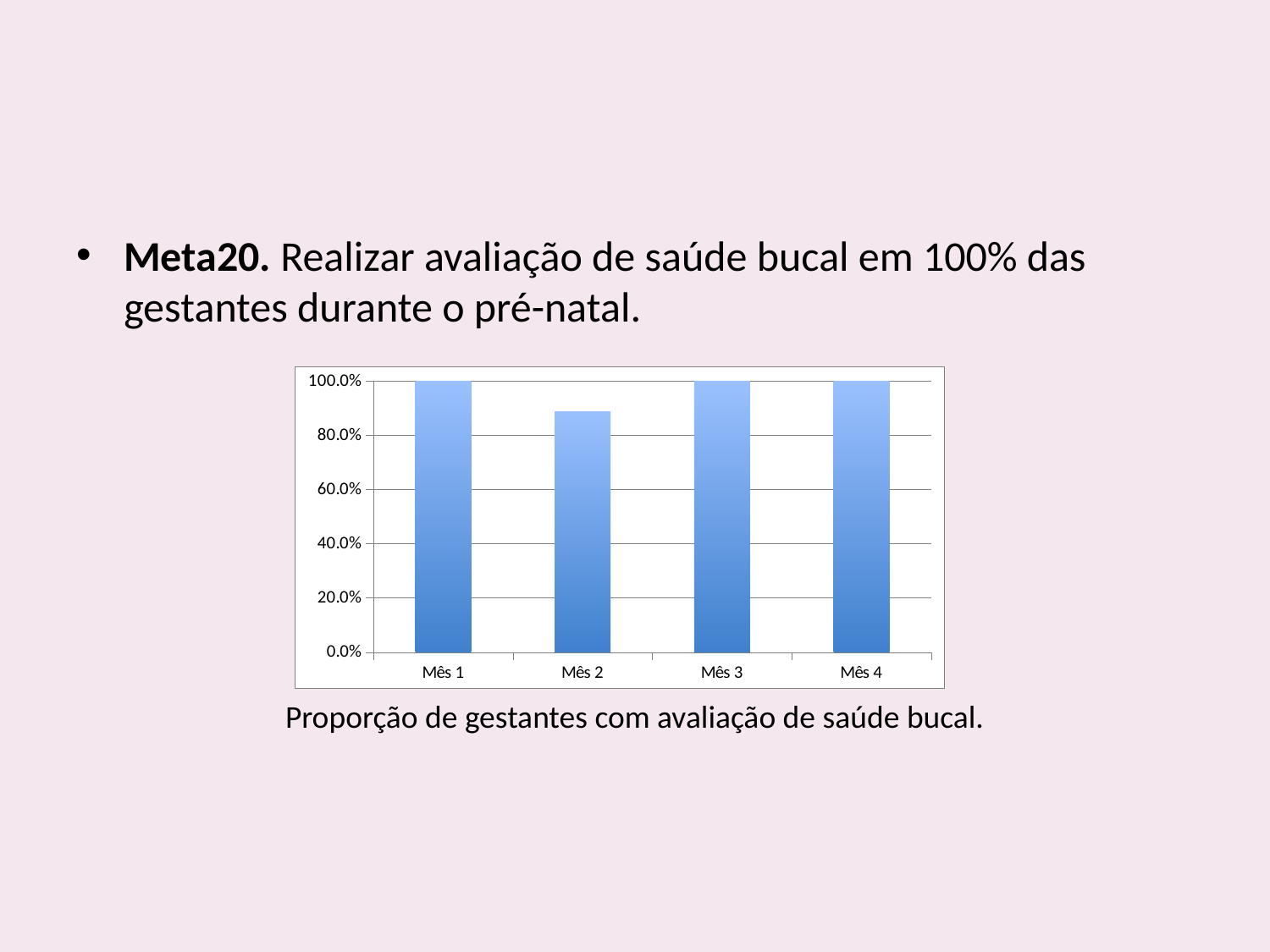
Is the value for Mês 2 greater or less than 100.0%? less What is the value for Mês 3? 100.0% How many categories (months) are plotted on the chart? 4 Is the value for Mês 2 greater or less than 80.0%? greater What kind of chart is shown on the slide? bar chart What is the highest value shown on the vertical axis? 100.0% What is the value for Mês 4? 100.0% Which month has the lowest value? Mês 2 What is the value for Mês 1? 100.0% What is the caption written below the chart? Proporção de gestantes com avaliação de saúde bucal. Which is larger, the value for Mês 2 or the value for Mês 4? Mês 4 Which is larger, the value for Mês 1 or the value for Mês 2? Mês 1